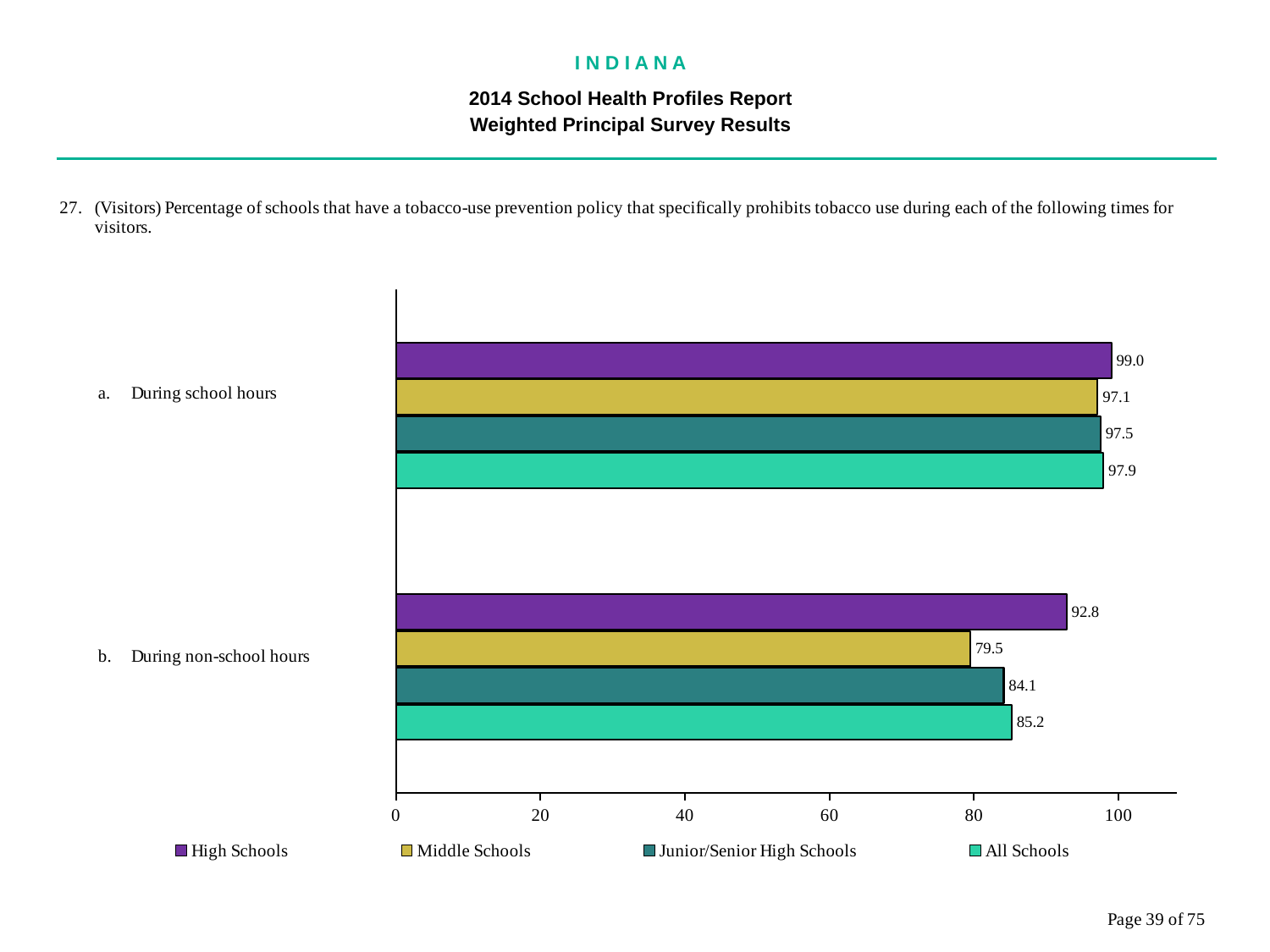
How many categories (time periods) are shown on the chart? 2 Is the value for Middle Schools during non-school hours greater or less than 80? less Which school type has the lowest value during non-school hours? Middle Schools What is the value for High Schools during school hours? 99.0 What is the value for Middle Schools during non-school hours? 79.5 What is the value for All Schools during non-school hours? 85.2 What is the difference between the High Schools values for school hours and non-school hours? 6.2 What kind of chart is shown on the slide? bar chart Which school type has the highest value during school hours? High Schools How many series does the legend list? 4 Which is larger: the Junior/Senior High Schools value during non-school hours or the All Schools value during non-school hours? All Schools What is the value for Junior/Senior High Schools during school hours? 97.5